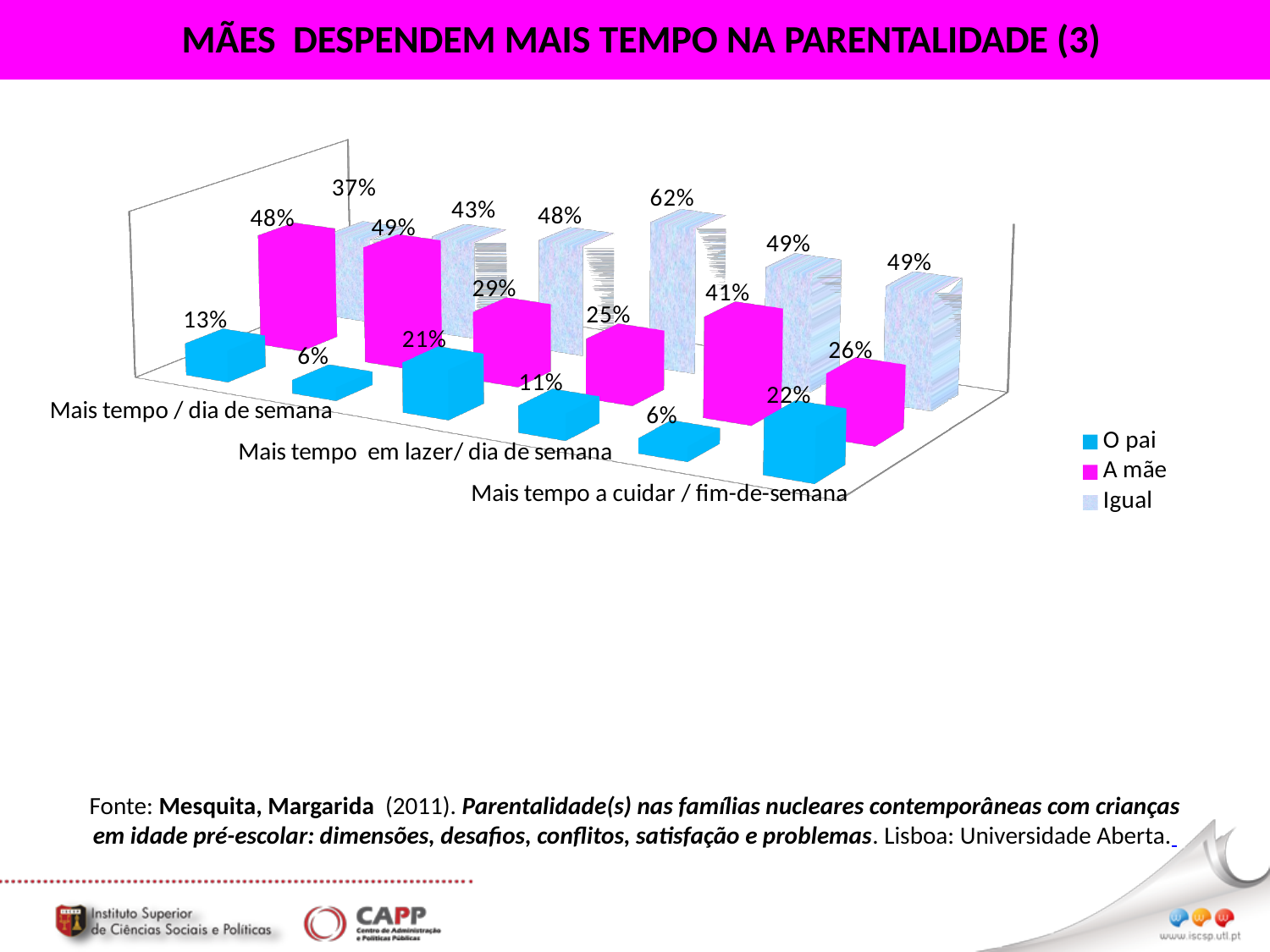
What is the highest value shown for the 'O pai' series? 22% What is the lowest value shown for the 'O pai' series? 6% What is the lowest value shown for the 'A mãe' series? 25% What are the three series named in the chart legend? O pai, A mãe, Igual What kind of chart is shown on the slide? Bar chart What is the highest value shown for the 'A mãe' series? 49% In the leftmost group of bars, which is larger, the 'O pai' value or the 'A mãe' value? A mãe What is the lowest value shown for the 'Igual' series? 37% How many series does the chart legend list? 3 In the leftmost group of bars, what is the difference between the 'A mãe' value (48%) and the 'O pai' value (13%)? 35 percentage points What is the highest value shown for the 'Igual' series? 62% How many bars are plotted for the 'O pai' series? 6